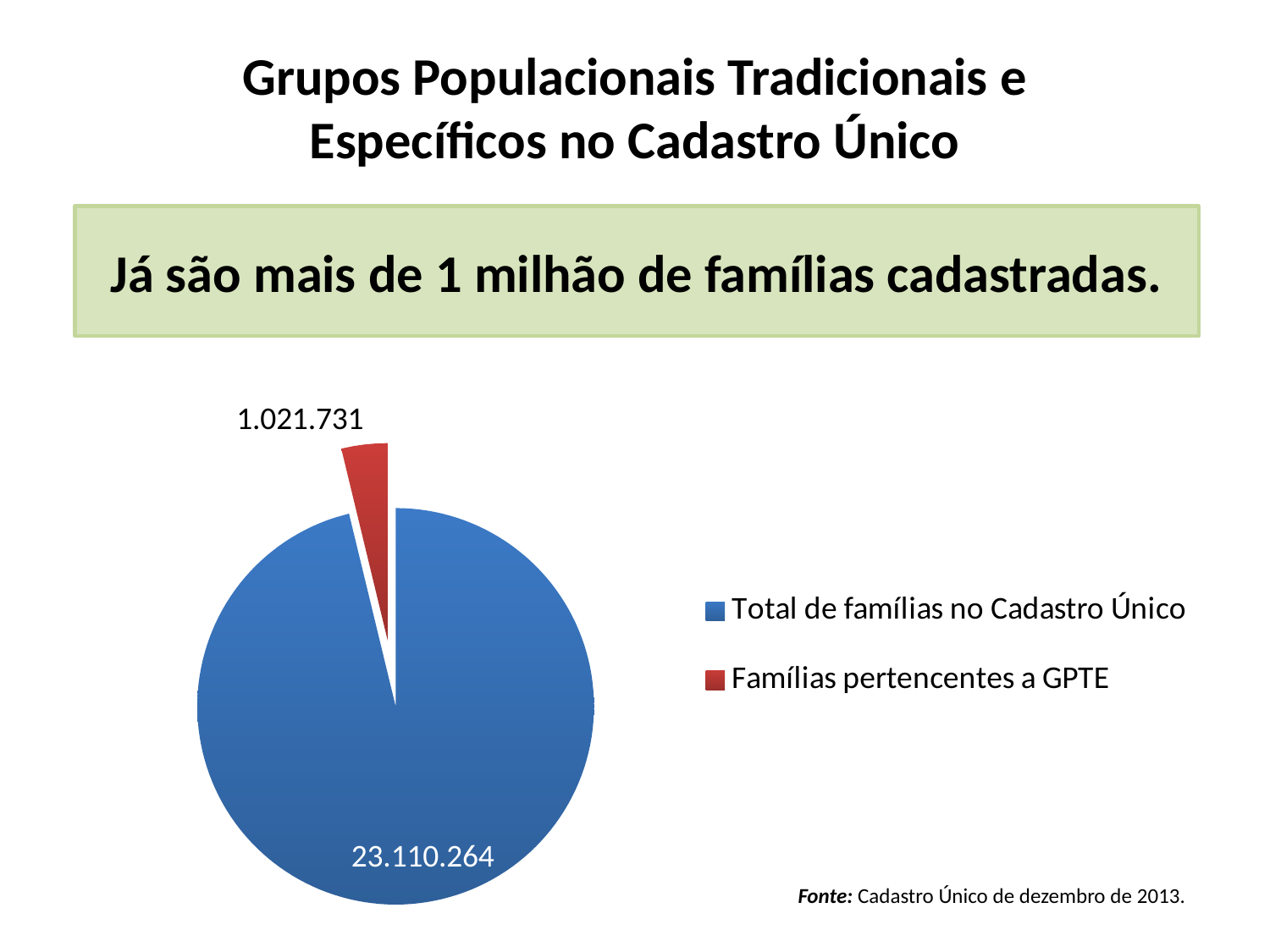
Which slice of the pie is the smallest? Famílias pertencentes a GPTE How many entries does the legend list? 2 What kind of chart is shown on the slide? Pie chart What is the difference between the value for "Total de famílias no Cadastro Único" and the value for "Famílias pertencentes a GPTE"? 22.088.533 Which slice of the pie is the largest? Total de famílias no Cadastro Único What is the sum of the two values shown in the pie chart? 24.131.995 Which is larger: the value for "Total de famílias no Cadastro Único" or the value for "Famílias pertencentes a GPTE"? Total de famílias no Cadastro Único What is the value shown for "Famílias pertencentes a GPTE"? 1.021.731 What is the value shown for "Total de famílias no Cadastro Único"? 23.110.264 What source is cited below the chart? Cadastro Único de dezembro de 2013 How many slices does the pie chart have? 2 What colour is the slice for "Famílias pertencentes a GPTE"? Red